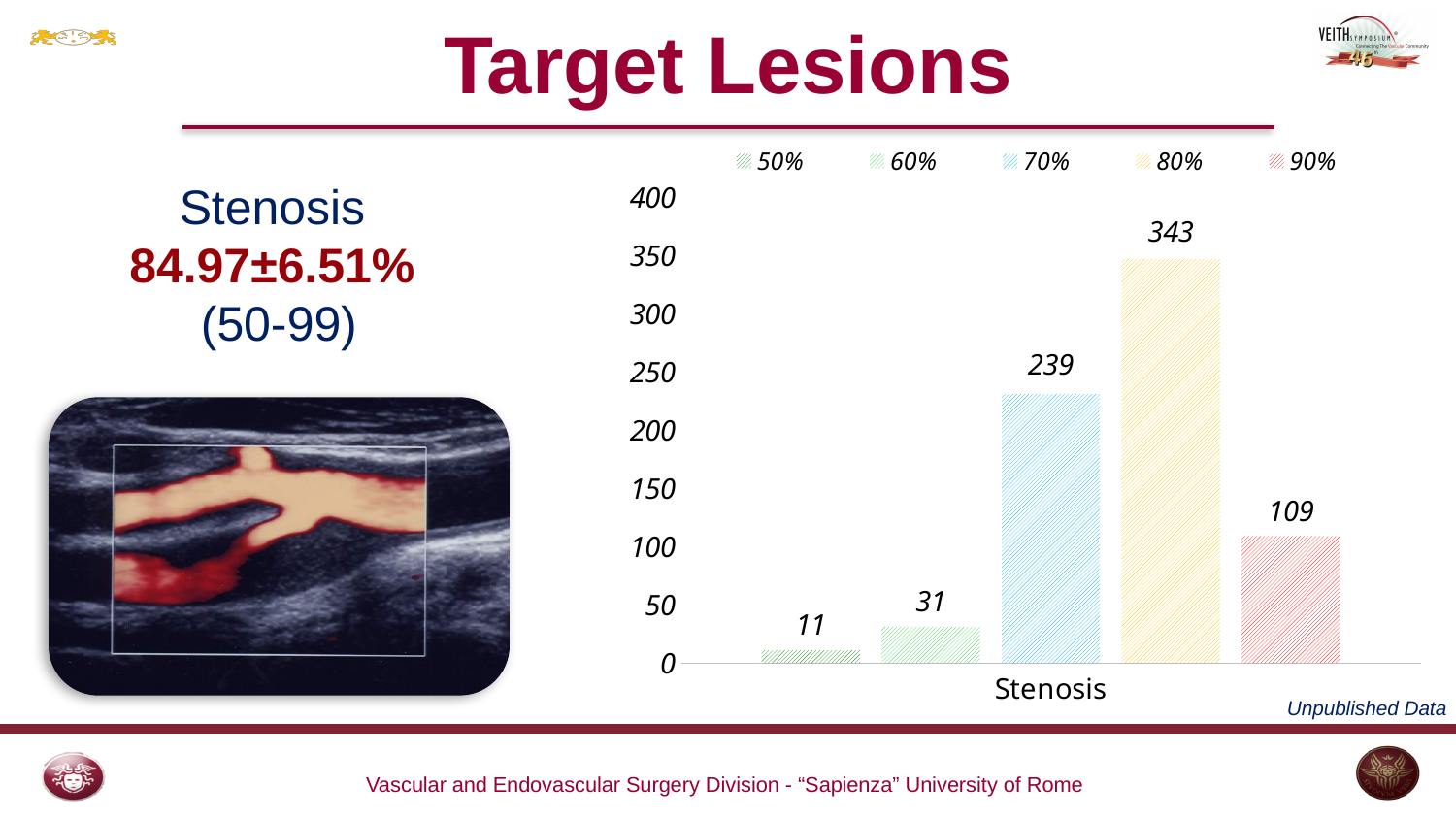
What is the value for the 80% stenosis series? 343 What is the label on the x axis of the chart? Stenosis What is the value for the 70% stenosis series? 239 What kind of chart is shown on the slide? bar chart How many series does the legend list? 5 Which stenosis series has the lowest value? 50% What is the difference between the values for the 90% and 60% series? 78 What is the difference between the values for the 80% and 70% series? 104 What is the value for the 50% stenosis series? 11 Which is larger, the value for the 90% series or the 60% series? 90% Is the value for the 70% series greater or less than 200? greater Which stenosis series has the highest value? 80%